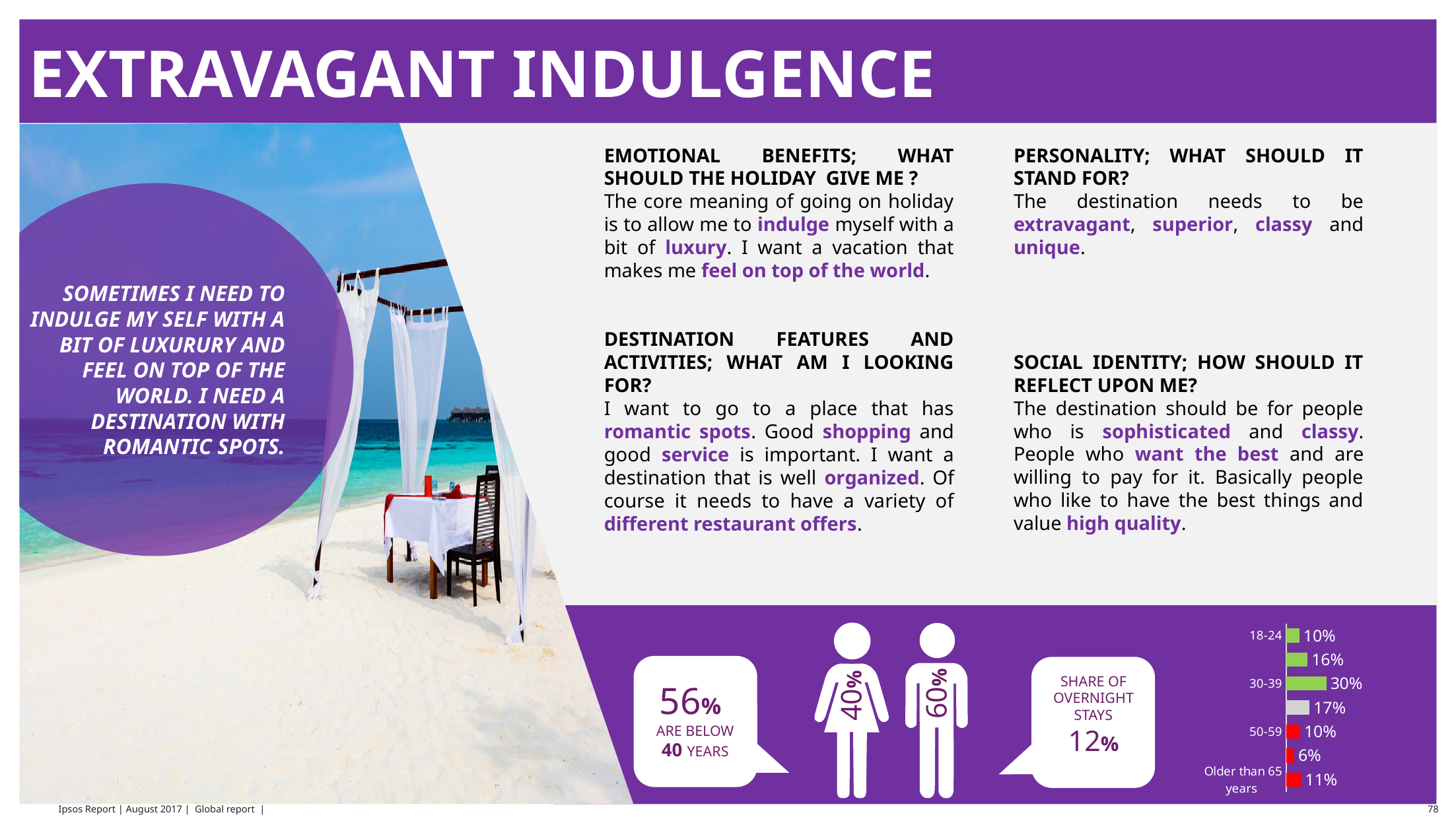
In the age-group bar chart at the bottom right, what is the value for 50-59? 10% In the age-group bar chart at the bottom right, what is the value for 30-39? 30% In the age-group bar chart at the bottom right, what is the lowest value shown on any bar? 6% In the age-group bar chart at the bottom right, which is larger, the value for 30-39 or the value for Older than 65 years? 30-39 In the age-group bar chart at the bottom right, what colour are the bars for 50-59 and Older than 65 years? Red In the age-group bar chart at the bottom right, what is the value for Older than 65 years? 11% In the age-group bar chart at the bottom right, what is the difference between the values for Older than 65 years and 50-59? 1% How many bars are plotted in the age-group bar chart at the bottom right? 7 In the age-group bar chart at the bottom right, what is the difference between the values for 30-39 and 18-24? 20% What kind of chart is shown at the bottom right of the slide? Bar chart In the age-group bar chart at the bottom right, which labelled age group has the highest value? 30-39 In the age-group bar chart at the bottom right, what is the value for 18-24? 10%